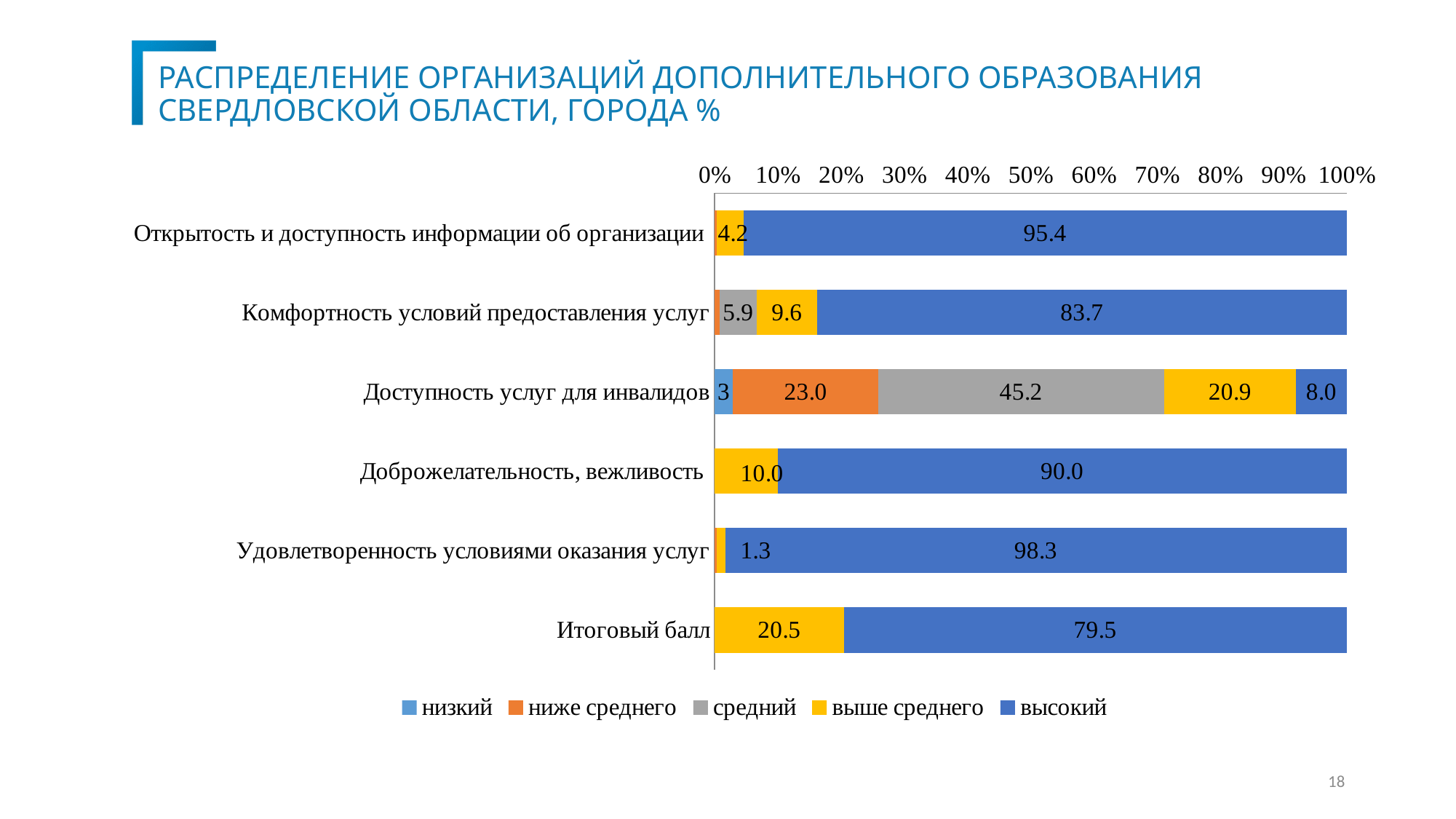
Which category has the lowest value for the 'высокий' series? Доступность услуг для инвалидов What is the difference between the 'высокий' values for 'Открытость и доступность информации об организации' and 'Комфортность условий предоставления услуг'? 11.7 What is the value of the 'средний' series for 'Доступность услуг для инвалидов'? 45.2 How many series does the legend list? 5 Is the 'высокий' value for 'Доброжелательность, вежливость' greater or less than 80%? greater What is the value of the 'выше среднего' series for 'Итоговый балл'? 20.5 What is the value of the 'высокий' series for 'Открытость и доступность информации об организации'? 95.4 What colour represents the 'высокий' series in the legend? blue What kind of chart is shown on the slide? stacked bar chart Which is larger for 'Доступность услуг для инвалидов': the 'ниже среднего' value or the 'выше среднего' value? ниже среднего Which category has the highest value for the 'высокий' series? Удовлетворенность условиями оказания услуг How many categories are plotted on the chart? 6